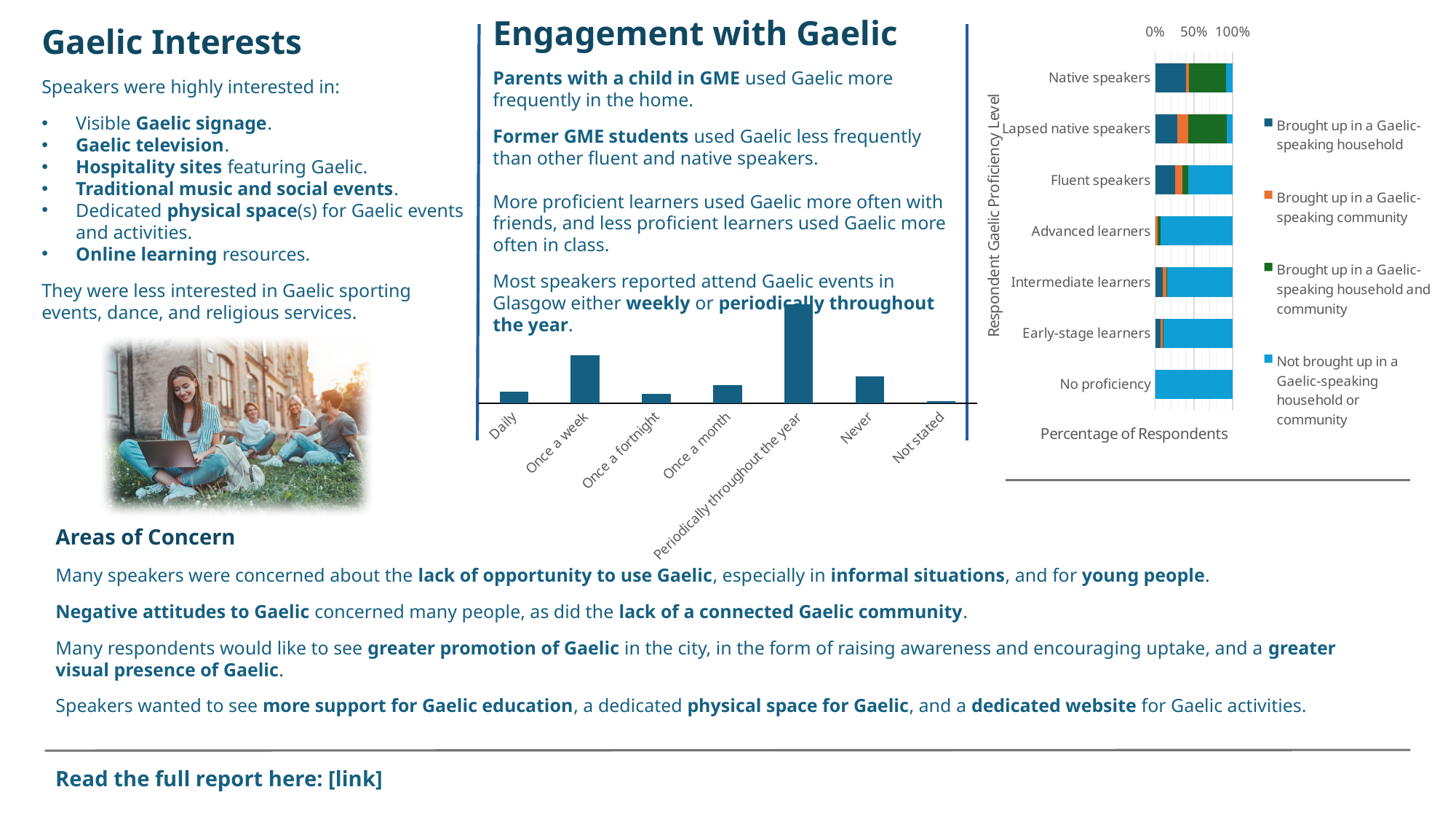
In the middle bar chart under 'Engagement with Gaelic', which is larger: the bar for 'Never' or the bar for 'Once a fortnight'? Never In the chart on the right, is the share of 'Not brought up in a Gaelic-speaking household or community' for Advanced learners greater or less than 50%? greater In the middle bar chart under 'Engagement with Gaelic', which category has the shortest bar? Not stated What kind of chart is the chart on the right showing Respondent Gaelic Proficiency Level? Stacked bar chart In the chart on the right, is the share of 'Not brought up in a Gaelic-speaking household or community' for Native speakers greater or less than 50%? less In the chart on the right, how many series does the legend list? 4 In the middle bar chart under 'Engagement with Gaelic', which category has the tallest bar? Periodically throughout the year In the chart on the right, how many proficiency levels are shown on the vertical axis? 7 In the middle bar chart under 'Engagement with Gaelic', how many categories are shown on the x axis? 7 In the chart on the right, what is the title of the vertical axis? Respondent Gaelic Proficiency Level In the chart on the right, what is the title of the horizontal axis? Percentage of Respondents In the middle bar chart under 'Engagement with Gaelic', which is larger: the bar for 'Once a week' or the bar for 'Daily'? Once a week